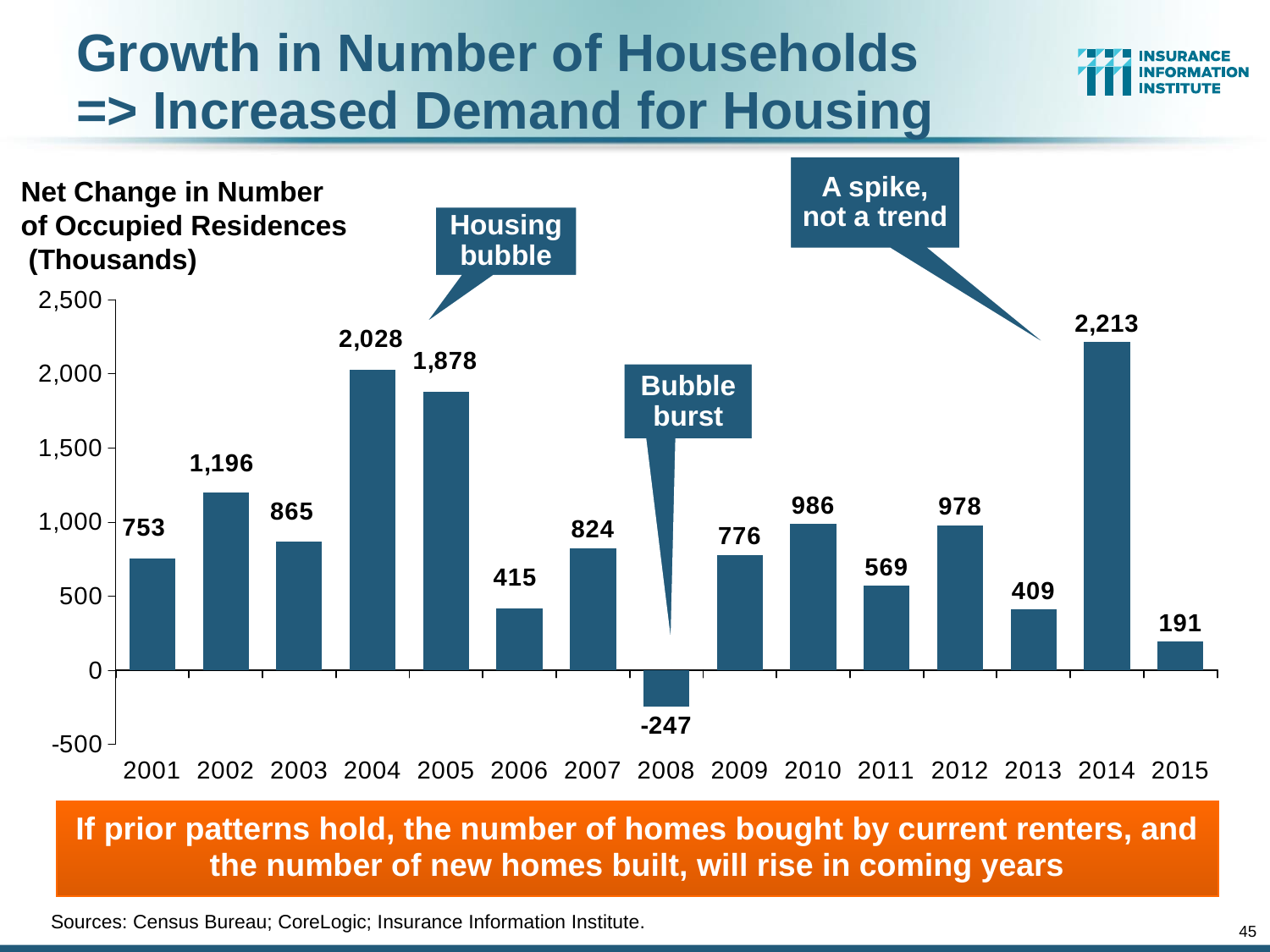
How many years are shown on the x axis? 15 What kind of chart is shown on the slide? Bar chart Do the values rise or fall from 2012 to 2013? Fall What is the difference between the values for 2014 and 2013? 1,804 What value is shown for 2008? -247 Which year has the lowest net change in number of occupied residences? 2008 Which year has the larger value, 2010 or 2012? 2010 What is the value for 2015? 191 What is the net change in number of occupied residences for 2004? 2,028 Which year has the highest net change in number of occupied residences? 2014 What label does the callout pointing to the 2014 bar show? A spike, not a trend Is the value for 2002 greater or less than 1,000? greater